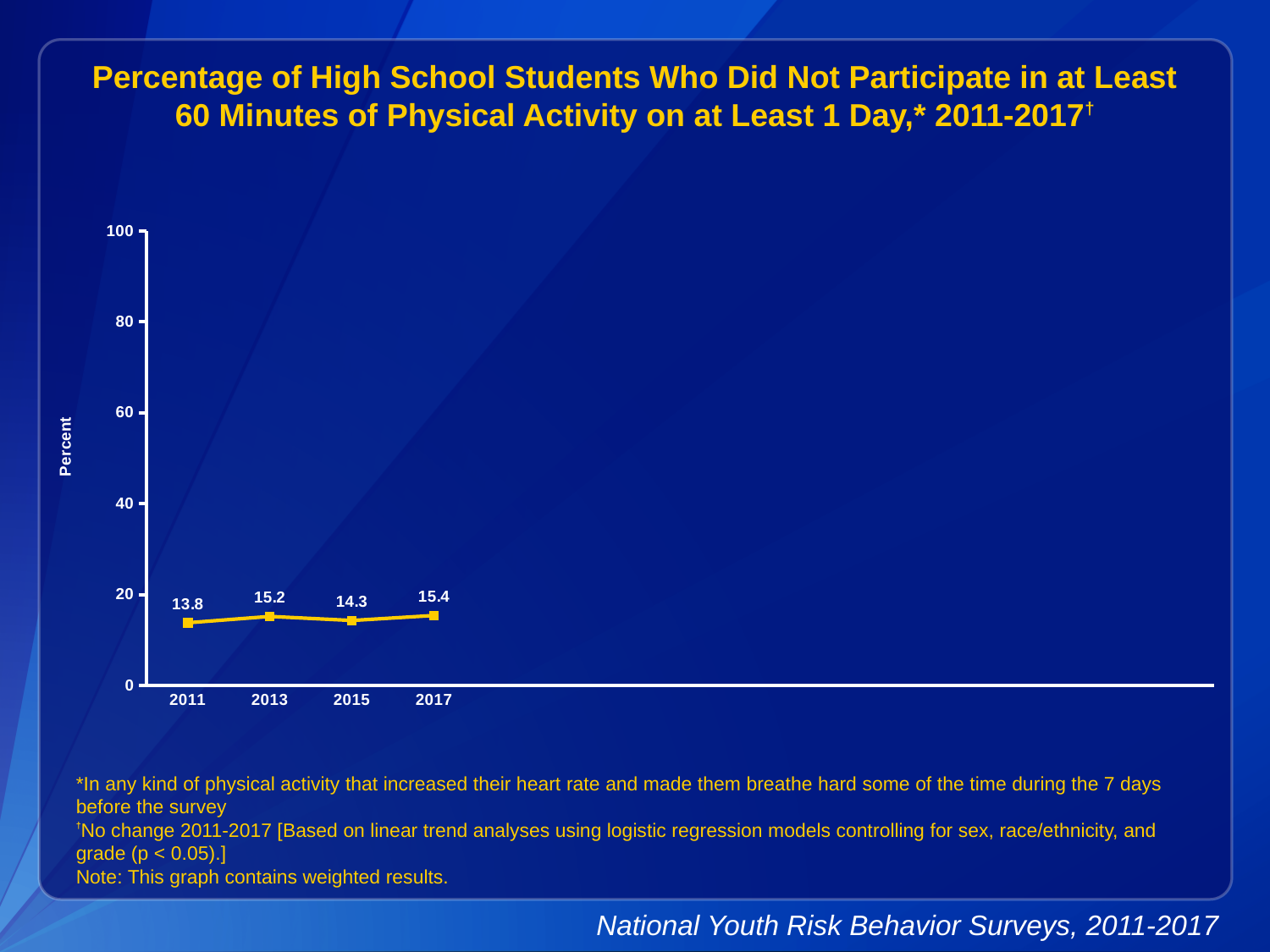
What is the value for 2017? 15.4 What is the label on the y axis? Percent Which year has the highest value? 2017 What is the value for 2011? 13.8 What is the value for 2013? 15.2 Which is larger, the value for 2013 or the value for 2015? 2013 How many years are plotted on the chart? 4 What is the value for 2015? 14.3 What kind of chart is shown on the slide? line chart What is the difference between the values for 2017 and 2011? 1.6 Is the value for 2017 greater or less than 20? less Which year has the lowest value? 2011